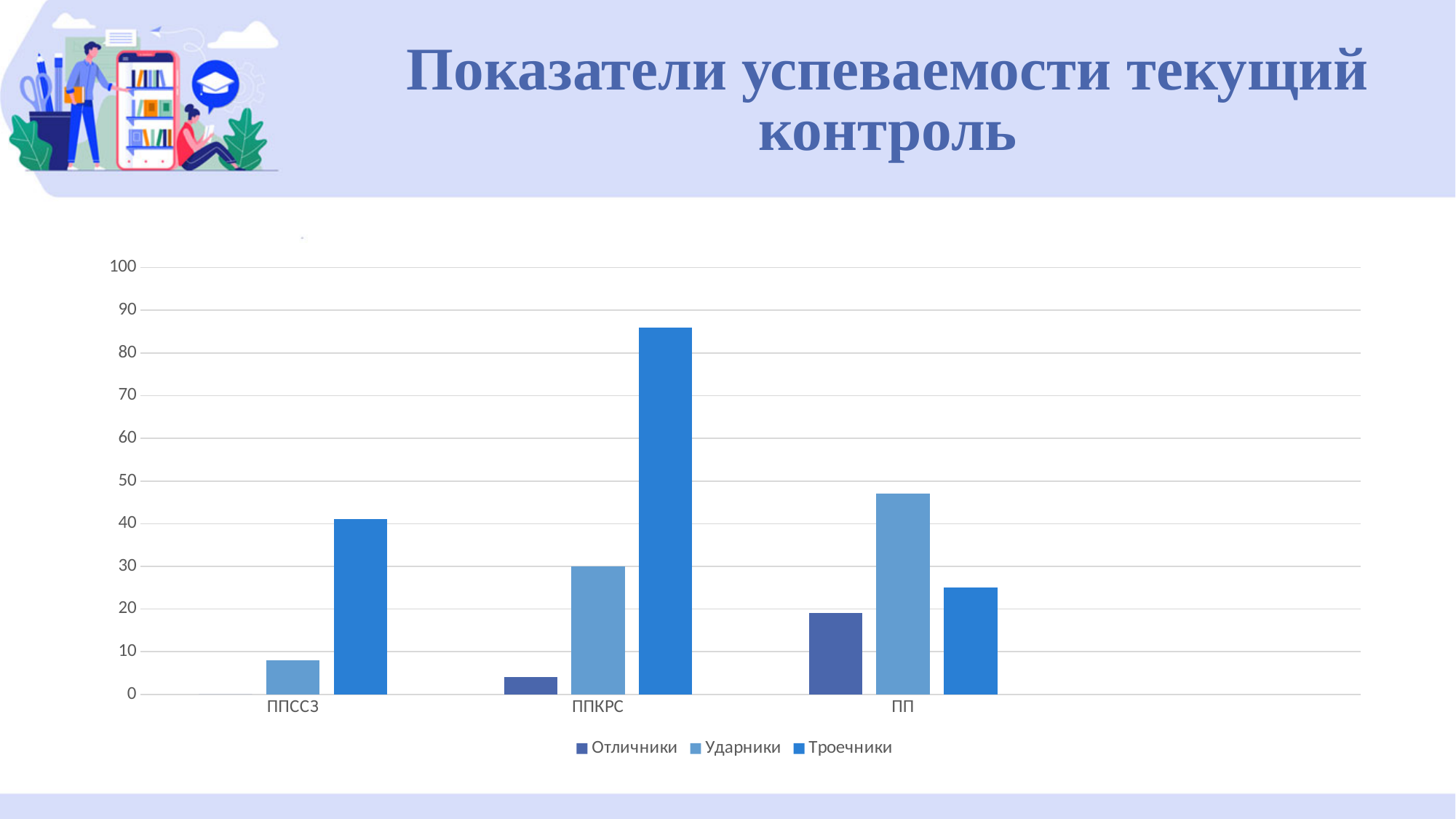
Is the value for Ударники in ППССЗ greater or less than 10? less Which category has the highest value for Ударники? ПП Which category has the highest value for Троечники? ППКРС How many series does the legend list? 3 How many categories are shown on the x axis? 3 Is the value for Троечники in ППКРС greater or less than 80? greater Which category has the highest value for Отличники? ПП In the ПП category, which is larger: Ударники or Троечники? Ударники What kind of chart is shown on the slide? bar chart What is the title of the slide? Показатели успеваемости текущий контроль